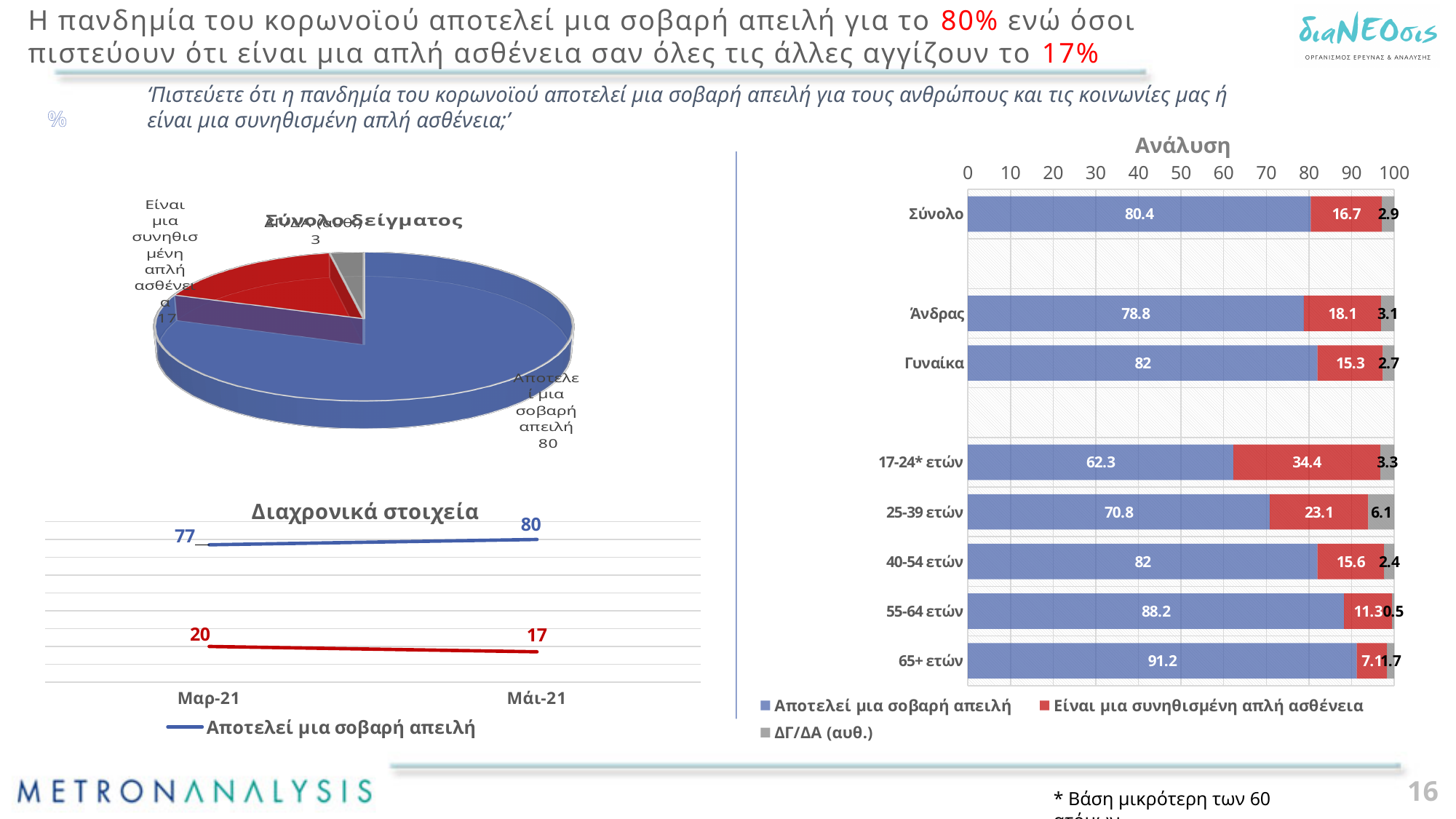
In the 'Διαχρονικά στοιχεία' line chart, what is the value of 'Αποτελεί μια σοβαρή απειλή' for 'Μάι-21'? 80 In the 'Ανάλυση' bar chart, which category has the highest value for 'Είναι μια συνηθισμένη απλή ασθένεια'? 17-24* ετών In the 'Ανάλυση' bar chart, how many series does the legend list? 3 In the 'Ανάλυση' bar chart, what is the total of the 'Σύνολο' stacked bar? 100 In the 'Ανάλυση' bar chart, how many categories are shown? 8 What kind of chart is the 'Ανάλυση' chart? bar chart In the 'Ανάλυση' bar chart, what is the value of 'Αποτελεί μια σοβαρή απειλή' for '65+ ετών'? 91.2 In the 'Σύνολο δείγματος' pie chart, what share does 'Είναι μια συνηθισμένη απλή ασθένεια' have? 17 In the 'Διαχρονικά στοιχεία' line chart, does the 'Αποτελεί μια σοβαρή απειλή' line rise or fall from 'Μαρ-21' to 'Μάι-21'? rises In the 'Ανάλυση' bar chart, which category has the lowest value for 'Αποτελεί μια σοβαρή απειλή'? 17-24* ετών In the 'Ανάλυση' bar chart, what is the difference between 'Γυναίκα' and 'Άνδρας' for 'Αποτελεί μια σοβαρή απειλή'? 3.2 In the 'Ανάλυση' bar chart, which is larger for 'ΔΓ/ΔΑ (αυθ.)': '25-39 ετών' or '40-54 ετών'? 25-39 ετών